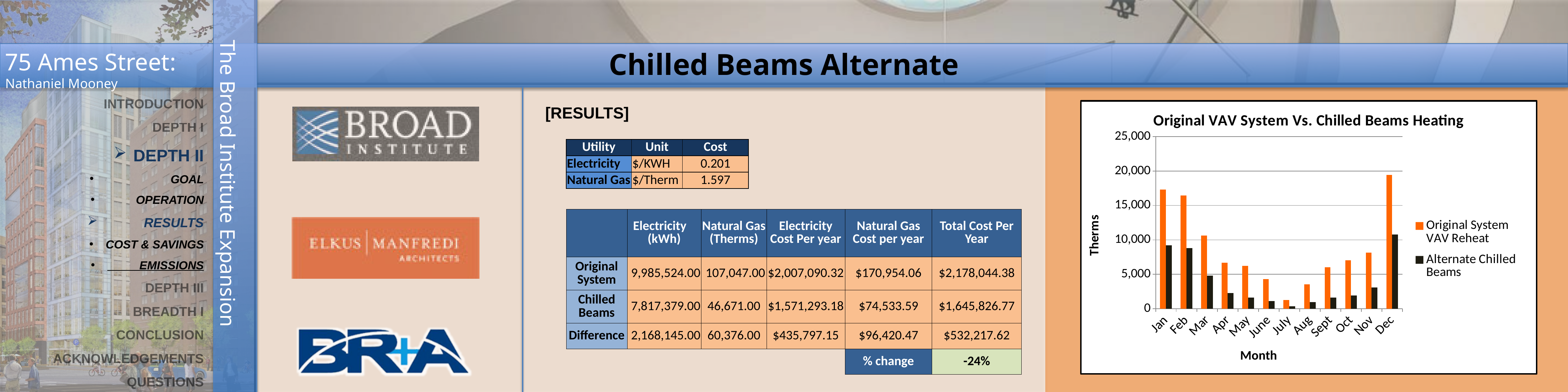
In which month is the Original System VAV Reheat value highest? Dec Is the Alternate Chilled Beams value for Jan greater or less than 10,000? less Is the Original System VAV Reheat value for Jan greater or less than 15,000? greater How many months are shown on the x axis of the chart? 12 Is the Original System VAV Reheat value for July greater or less than 5,000? less Do the Original System VAV Reheat values rise or fall from Jan to July? fall How many series does the legend of the chart list? 2 In Jan, which series has the larger value: Original System VAV Reheat or Alternate Chilled Beams? Original System VAV Reheat What is the title of the chart? Original VAV System Vs. Chilled Beams Heating In which month is the Alternate Chilled Beams value highest? Dec In which month is the Original System VAV Reheat value lowest? July What kind of chart is shown on the slide? bar chart